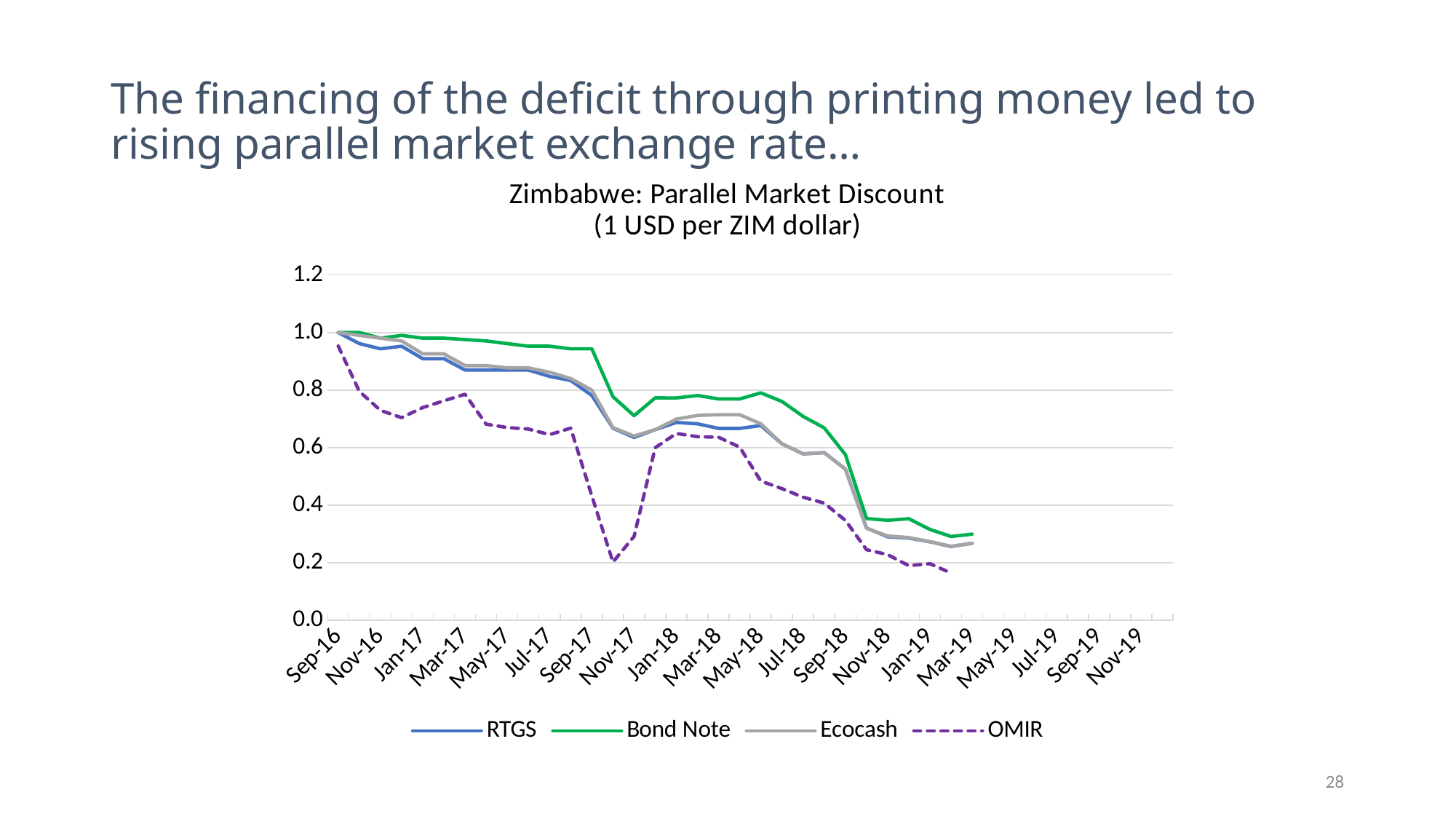
At Mar-17, which is larger: the Bond Note value or the OMIR value? Bond Note Is the OMIR value at Nov-18 greater or less than 0.4? less How many date labels are shown on the x axis? 20 How many series does the legend list? 4 Which series is drawn with a dashed line? OMIR What kind of chart is shown on the slide? Line chart What is the title of the chart? Zimbabwe: Parallel Market Discount (1 USD per ZIM dollar) Is the Bond Note value at Sep-17 greater or less than 0.8? greater Do the values of the Bond Note series generally rise or fall from Sep-16 to Mar-19? Fall Which series has the highest value at Sep-18? Bond Note Which series has the lowest values for most of the period shown? OMIR Is the RTGS value at Jan-18 greater or less than 0.6? greater